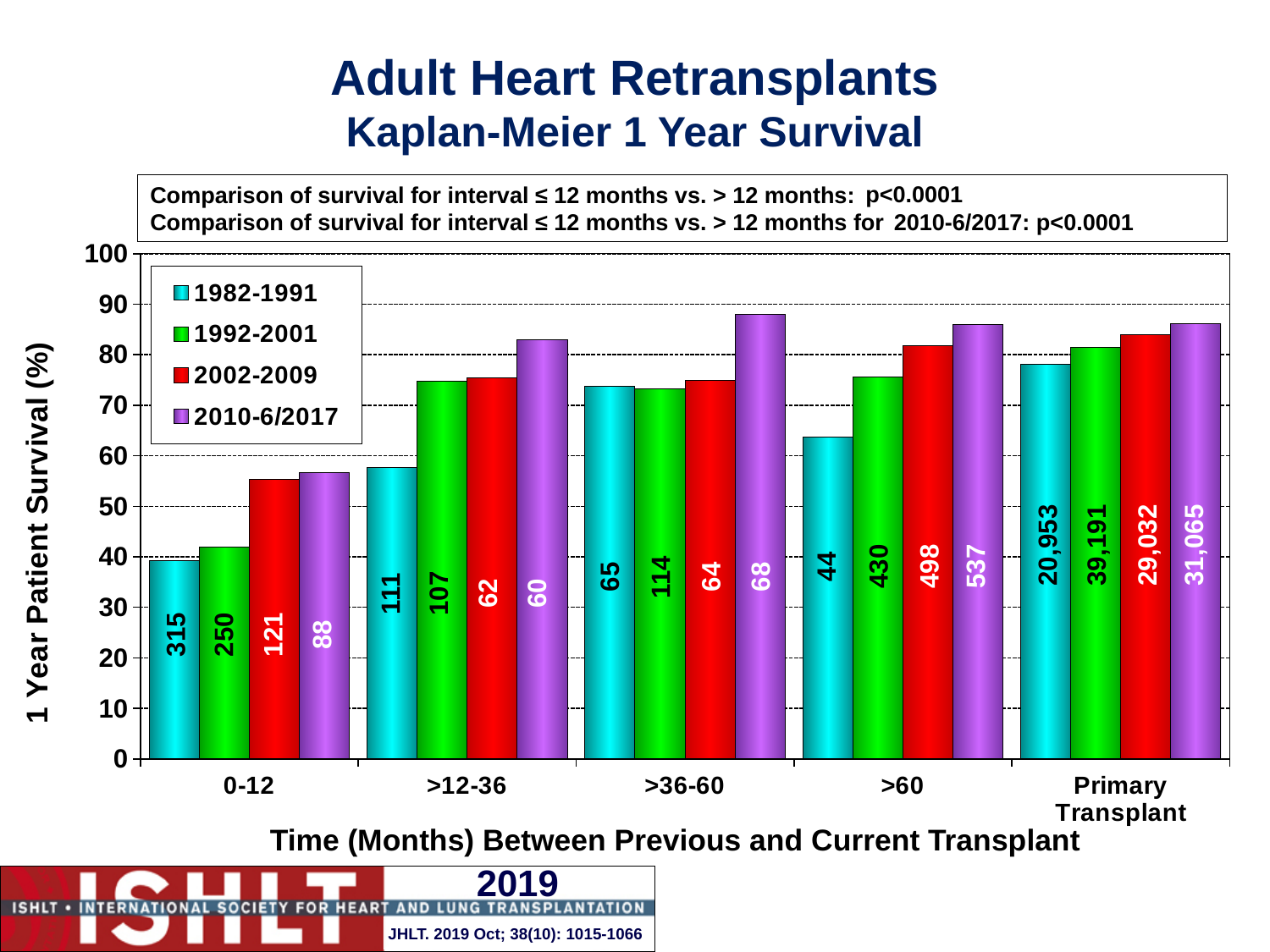
What number is printed on the 2010-6/2017 bar for the Primary Transplant category? 31,065 What kind of chart is shown on the slide? bar chart What number is printed on the 1982-1991 bar for the 0-12 month interval? 315 Within the >60 month interval, do the survival values rise or fall from the 1982-1991 era to the 2010-6/2017 era? rise How many series does the legend list? 4 Which is larger: the 1992-2001 survival for the 0-12 interval or the 1992-2001 survival for the >12-36 interval? >12-36 What number is printed on the 2002-2009 bar for the >60 month interval? 498 Is the 1 year patient survival for 1982-1991 in the Primary Transplant category greater or less than 80? less Which category and series has the lowest 1 year patient survival on the chart? 1982-1991 in 0-12 Is the 1 year patient survival for 2010-6/2017 in the >36-60 month interval greater or less than 80? greater How many categories are shown along the x axis? 5 Within the >60 month interval, which era has the highest 1 year patient survival? 2010-6/2017